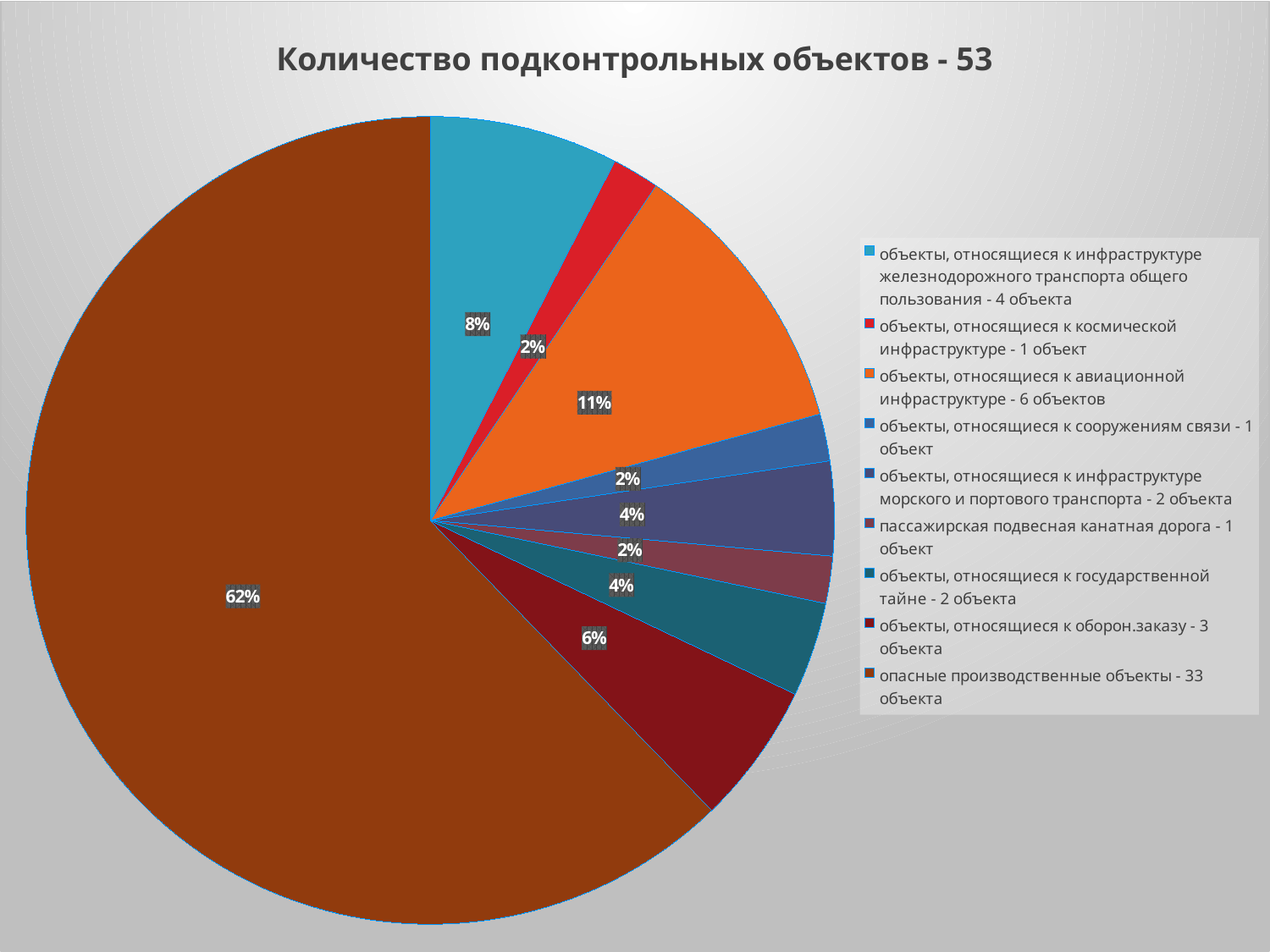
How many objects belong to the hazardous production facilities category according to the legend? 33 объекта What kind of chart is shown on the slide? pie chart Which has a larger share: the railway transport infrastructure objects or the aviation infrastructure objects? объекты, относящиеся к авиационной инфраструктуре What share of the pie do the defense order objects (объекты, относящиеся к оборон.заказу) take? 6% Which category has the largest share of the pie? опасные производственные объекты - 33 объекта How many slices does the pie chart have? 9 What share of the pie do the aviation infrastructure objects (объекты, относящиеся к авиационной инфраструктуре) take? 11% How many objects belong to the aviation infrastructure category according to the legend? 6 объектов What share of the pie do the hazardous production facilities (опасные производственные объекты) take? 62% What is the title of the chart? Количество подконтрольных объектов - 53 What is the difference in percentage points between the share of hazardous production facilities and the share of aviation infrastructure objects? 51%